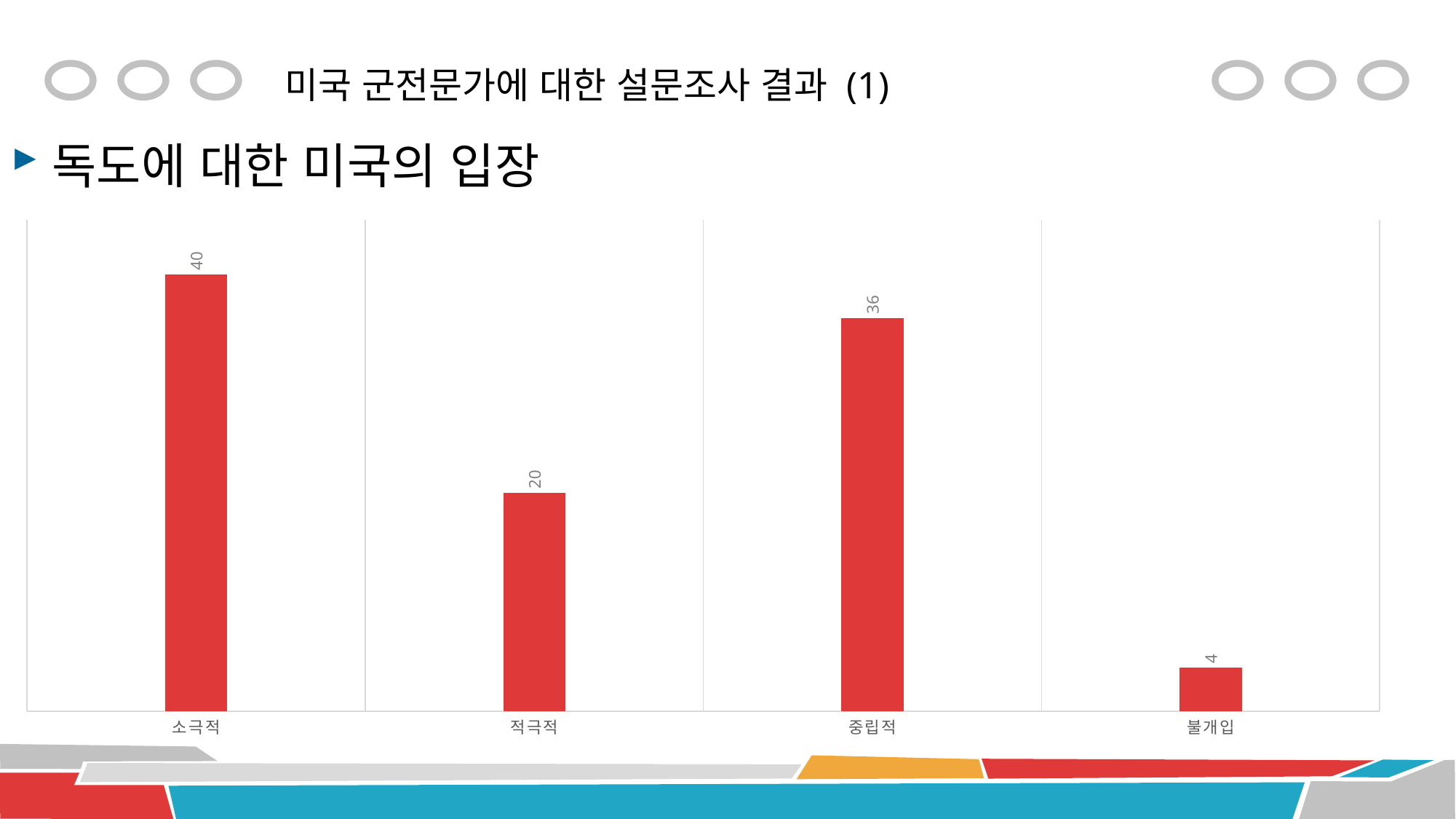
Which category has the highest value? 소극적 Which is larger, the value for 적극적 or the value for 중립적? 중립적 How many categories are shown in the chart? 4 What is the difference between the values for 적극적 and 불개입? 16 What is the value for 중립적? 36 What is the value for 소극적? 40 What is the value for 적극적? 20 What is the difference between the values for 소극적 and 중립적? 4 What kind of chart is shown on the slide? bar chart Which category has the lowest value? 불개입 What is the value for 불개입? 4 What colour are the bars in the chart? red